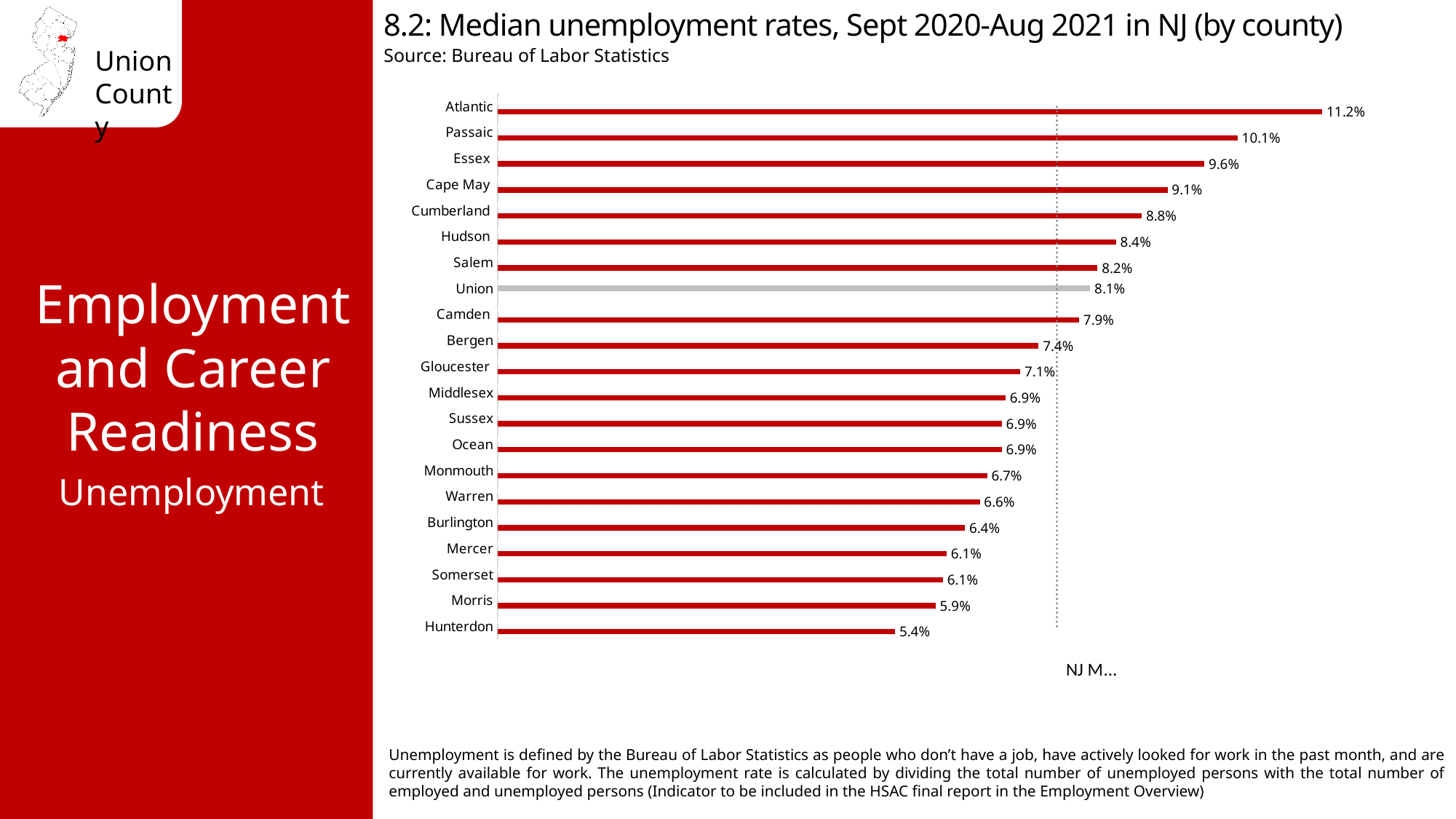
Which county has the lowest median unemployment rate on the chart? Hunterdon What is the difference between the median unemployment rates of Union and Camden counties? 0.2% What is the median unemployment rate shown for Morris county? 5.9% How many counties are shown on the chart? 21 What is the difference between the median unemployment rates of Atlantic and Hunterdon counties? 5.8% Which county's bar is coloured grey instead of red on the chart? Union What is the median unemployment rate shown for Hudson county? 8.4% Which county has a higher median unemployment rate, Bergen or Mercer? Bergen Which county has a higher median unemployment rate, Passaic or Essex? Passaic What is the median unemployment rate shown for Union county? 8.1% What kind of chart is used to show the median unemployment rates by county? Bar chart Which county has the highest median unemployment rate on the chart? Atlantic